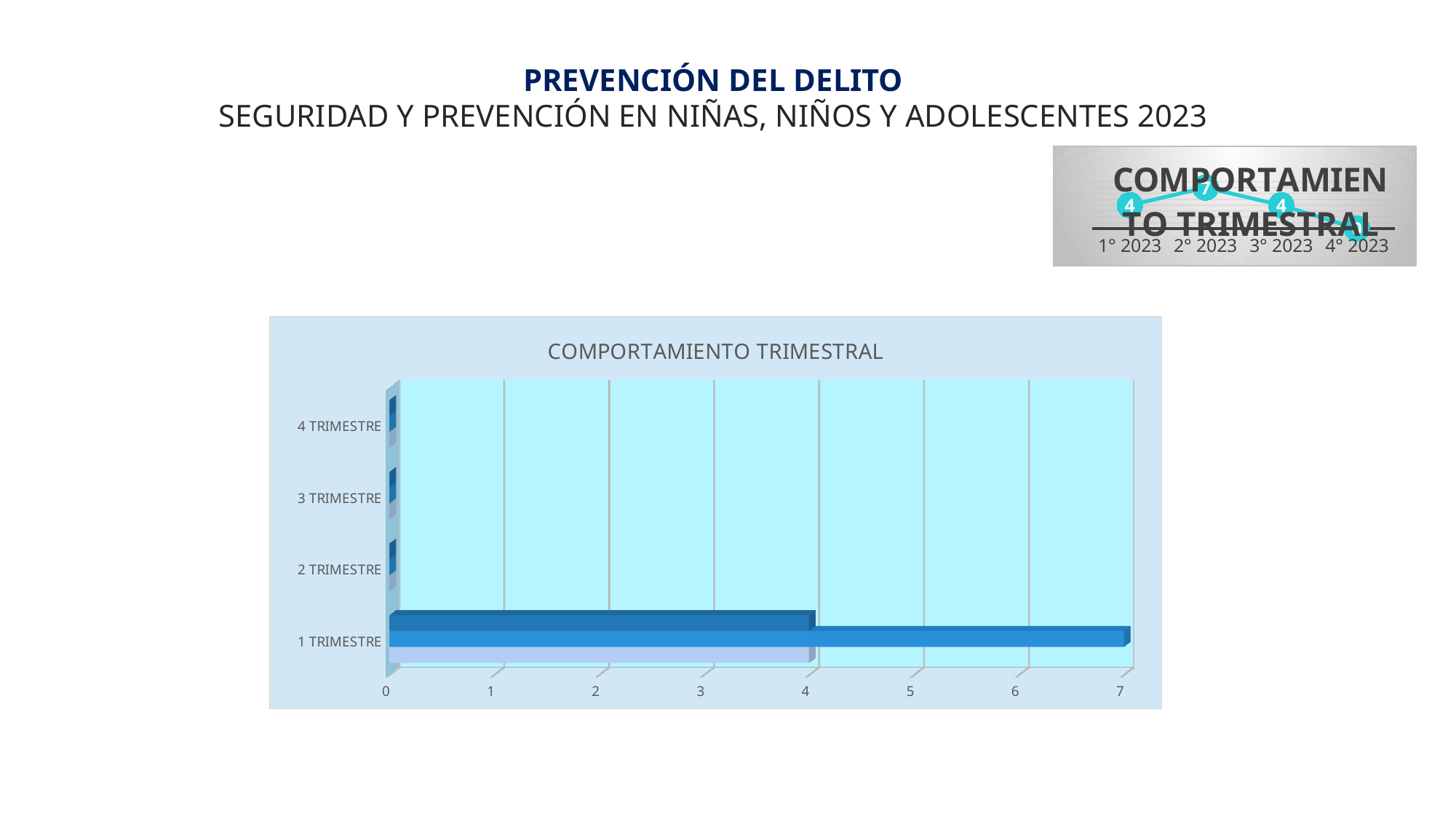
In the large bar chart, which category has the longest bar? 1 TRIMESTRE What kind of chart is the large chart in the lower part of the slide? bar chart In the small line chart at the top right, which quarter has the highest value? 2° 2023 In the small line chart at the top right, what is the value for 1° 2023? 4 In the small line chart at the top right, what is the value for 2° 2023? 7 In the small line chart at the top right, do the values rise or fall from 2° 2023 to 4° 2023? fall In the small line chart at the top right, what is the value for 4° 2023? 0 In the large bar chart, how many categories are shown on the vertical axis? 4 In the large bar chart, is the longest bar for 1 TRIMESTRE greater or less than 6? greater In the small line chart at the top right, how many data points are plotted? 4 In the small line chart at the top right, what is the difference between the values for 2° 2023 and 4° 2023? 7 In the small line chart at the top right, which quarter has the lowest value? 4° 2023